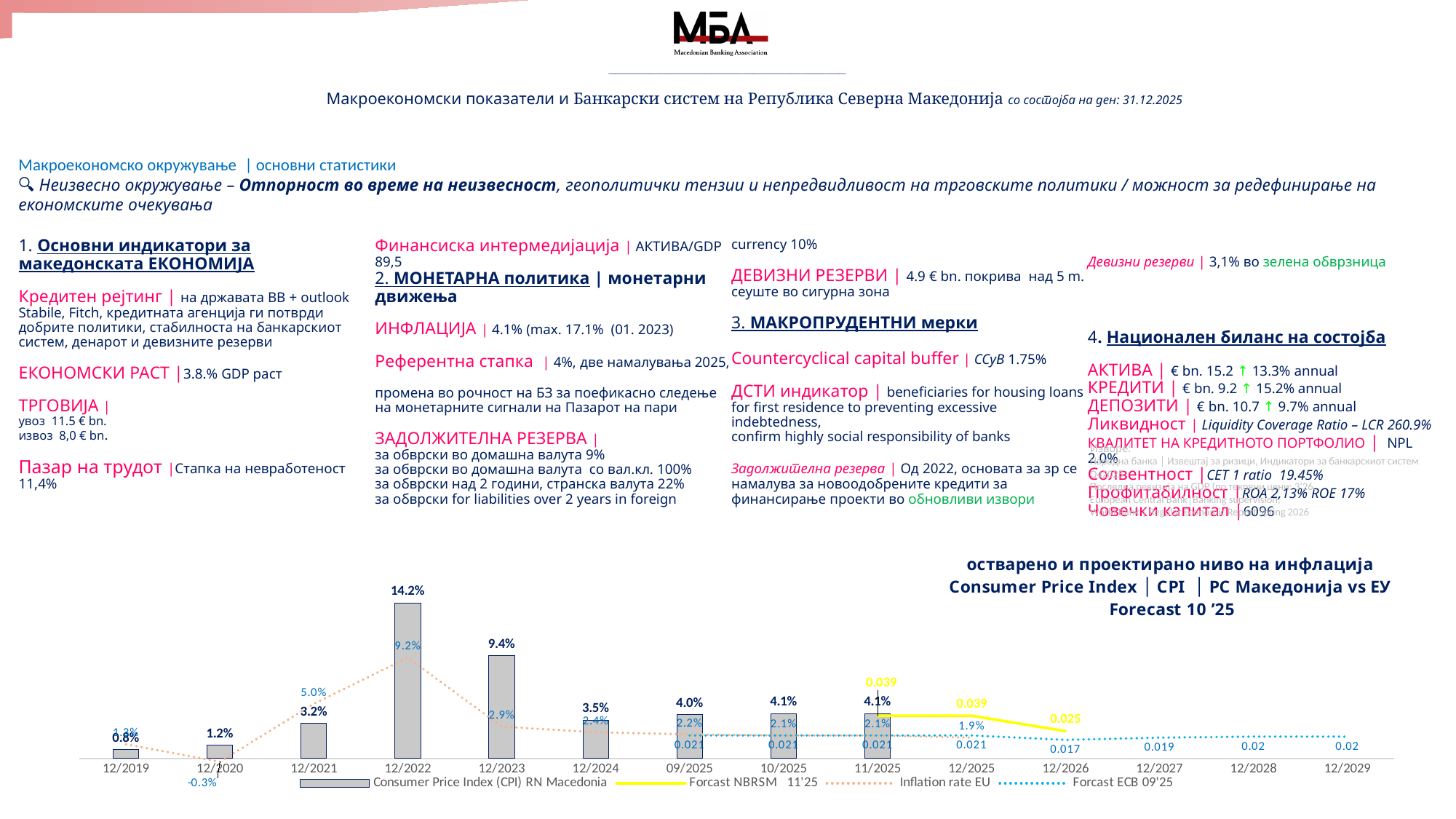
What is the Forcast ECB 09'25 value for 12/2027? 0.019 How many periods are shown on the x axis of the inflation chart? 14 Do the CPI RN Macedonia bars rise or fall from 12/2022 to 12/2024? Fall Which period has the highest Consumer Price Index (CPI) RN Macedonia bar? 12/2022 What is the Consumer Price Index (CPI) RN Macedonia value for 12/2022? 14.2% What is the Inflation rate EU value for 12/2020? -0.3% What is the Forcast NBRSM 11'25 value for 12/2026? 0.025 How many series does the legend of the inflation chart list? 4 For 12/2021, which is larger: the CPI RN Macedonia value or the Inflation rate EU value? Inflation rate EU What kind of chart is used to show the inflation data? Combination bar and line chart What is the difference between the CPI RN Macedonia values for 12/2022 and 12/2023? 4.8 percentage points Which period has the lowest Consumer Price Index (CPI) RN Macedonia bar? 12/2019